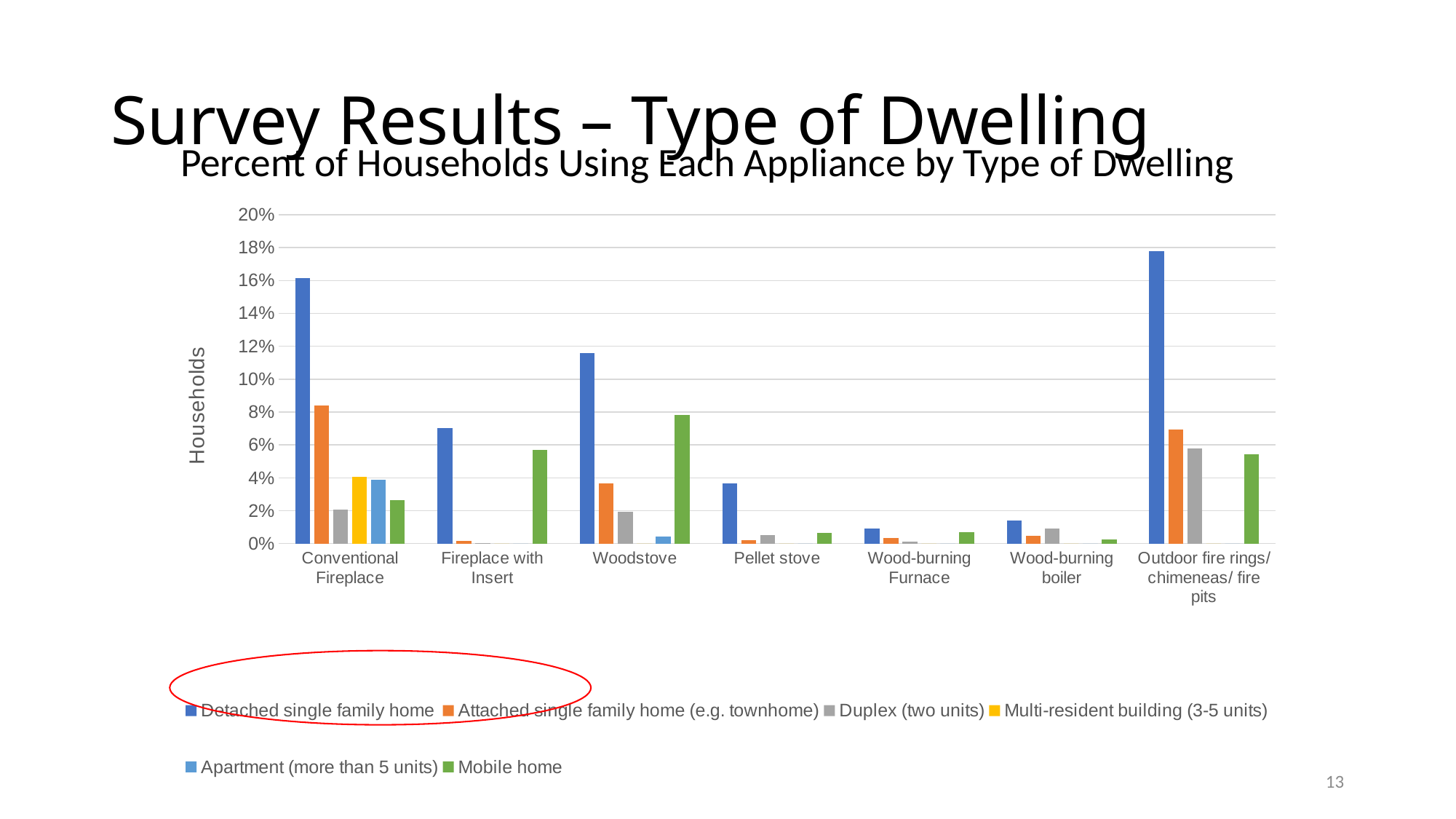
Is the Detached single family home value for Woodstove greater or less than 10%? greater For the Detached single family home series, which appliance has the highest value? Outdoor fire rings/ chimeneas/ fire pits What kind of chart is shown on the slide? bar chart For Conventional Fireplace, which is larger: the Detached single family home value or the Attached single family home value? Detached single family home How many series does the legend list? 6 What is the title of the y axis? Households For the Detached single family home series, which appliance has the lowest value? Wood-burning Furnace Is the Attached single family home value for Conventional Fireplace greater or less than 6%? greater Is the Detached single family home value for Conventional Fireplace greater or less than 14%? greater How many appliance categories are shown on the x axis? 7 For Woodstove, which is larger: the Mobile home value or the Attached single family home value? Mobile home